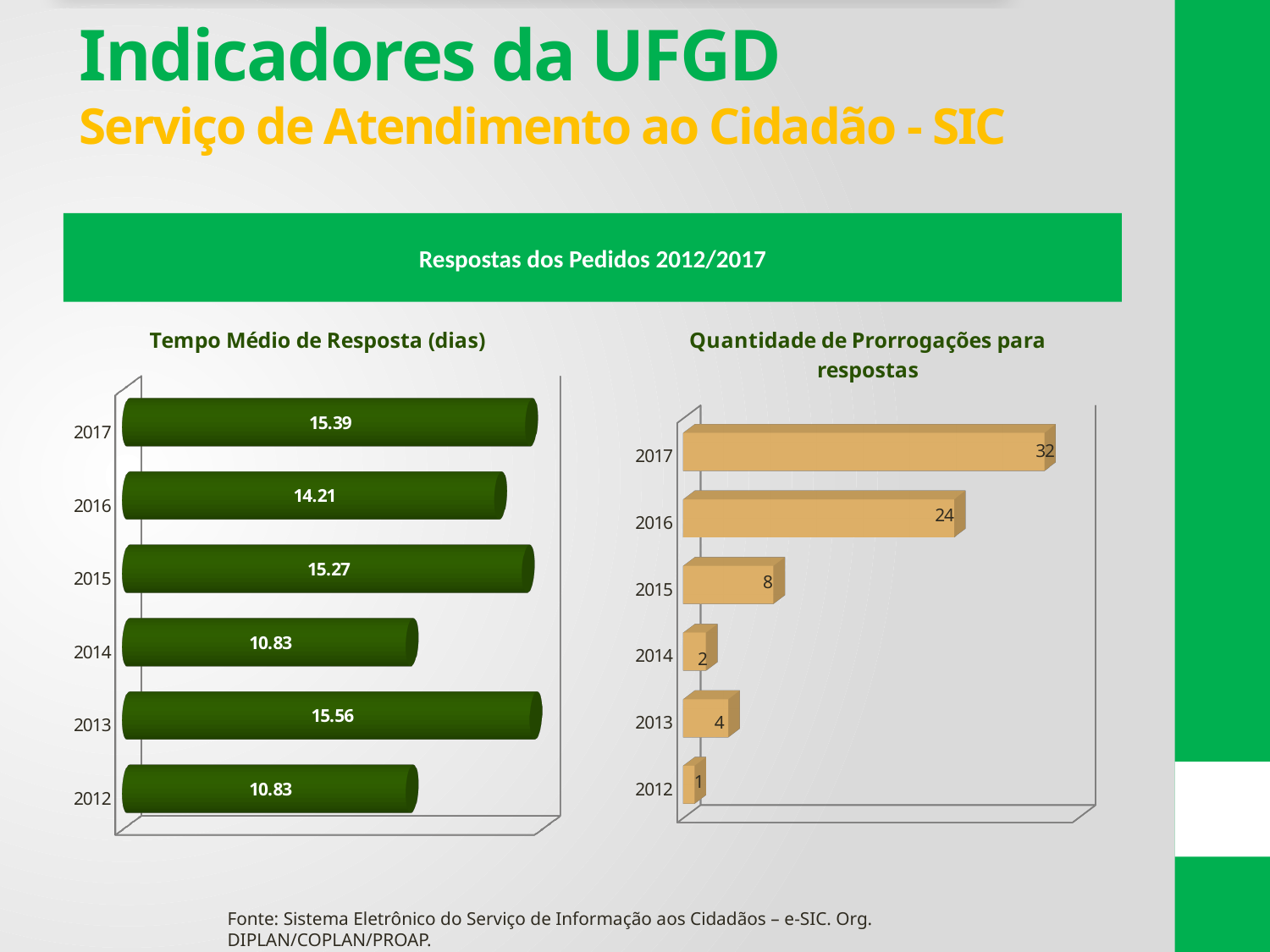
In the chart 'Quantidade de Prorrogações para respostas', what is the value for 2013? 4 In the chart 'Quantidade de Prorrogações para respostas', what is the difference between the values for 2017 and 2015? 24 In the chart 'Tempo Médio de Resposta (dias)', what is the value for 2017? 15.39 In the chart 'Quantidade de Prorrogações para respostas', which year has the lowest value? 2012 What kind of chart is 'Quantidade de Prorrogações para respostas'? Bar chart In the chart 'Tempo Médio de Resposta (dias)', what is the difference between the values for 2015 and 2014? 4.44 In the chart 'Quantidade de Prorrogações para respostas', which is larger, the value for 2014 or the value for 2013? 2013 In the chart 'Tempo Médio de Resposta (dias)', how many years are shown? 6 In the chart 'Quantidade de Prorrogações para respostas', what is the value for 2016? 24 In the chart 'Tempo Médio de Resposta (dias)', which year has the highest value? 2013 In the chart 'Tempo Médio de Resposta (dias)', what is the value for 2016? 14.21 In the chart 'Quantidade de Prorrogações para respostas', which year has the highest value? 2017